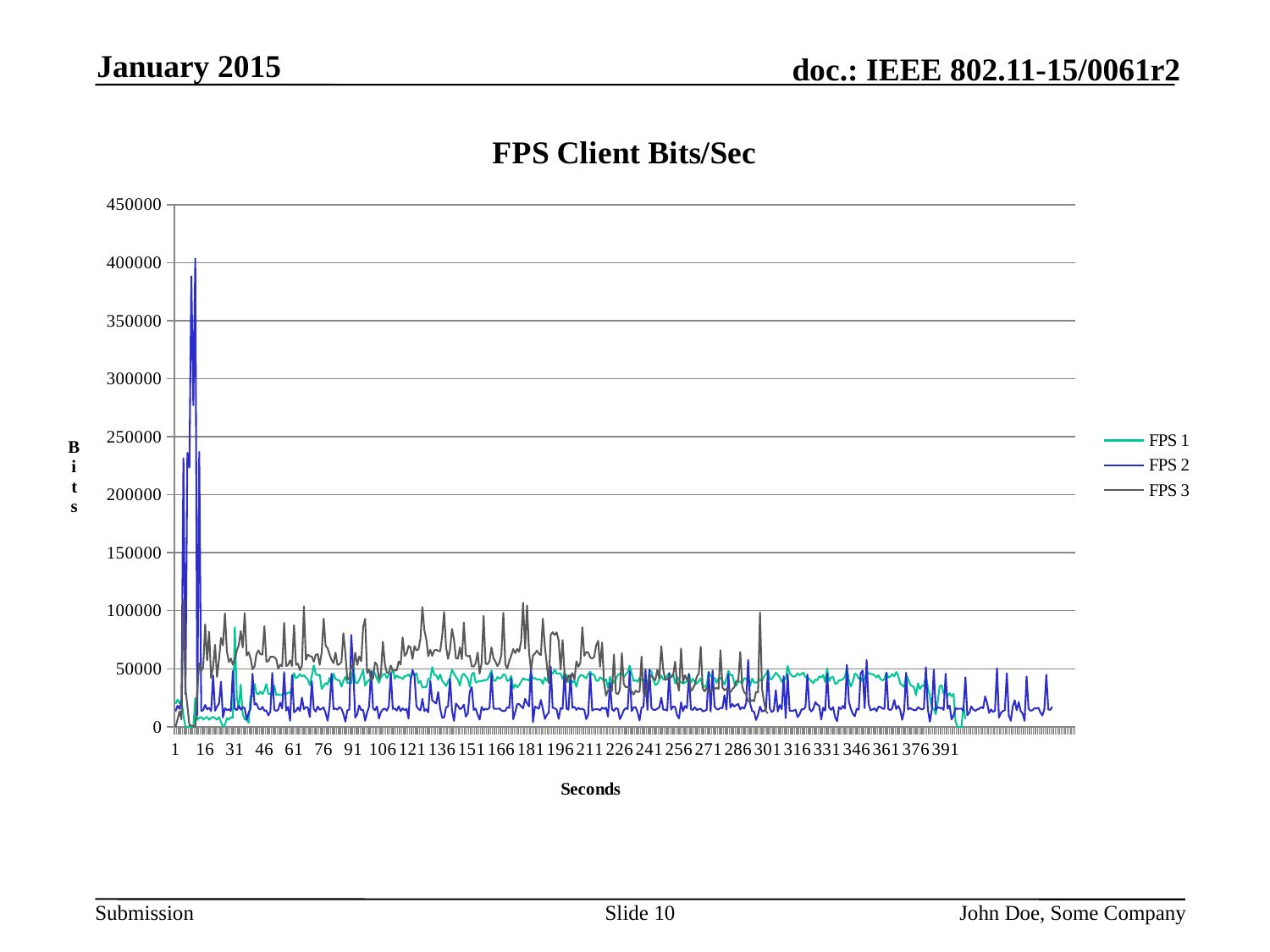
What is the highest value shown on the y axis? 450000 What is the title of the chart? FPS Client Bits/Sec Is the peak value of the FPS 2 series greater or less than 350000? greater Is the peak value of the FPS 3 series greater or less than 300000? less Which series extends furthest along the x axis (to the highest second)? FPS 2 How many series does the legend list? 3 What are the names of the series listed in the legend? FPS 1, FPS 2, FPS 3 What is the interval between consecutive x-axis tick labels? 15 Is the value of FPS 2 at second 391 greater or less than 100000? less What kind of chart is shown on the slide? line chart Do the FPS 3 values generally rise or fall along the x axis after the initial spike? fall